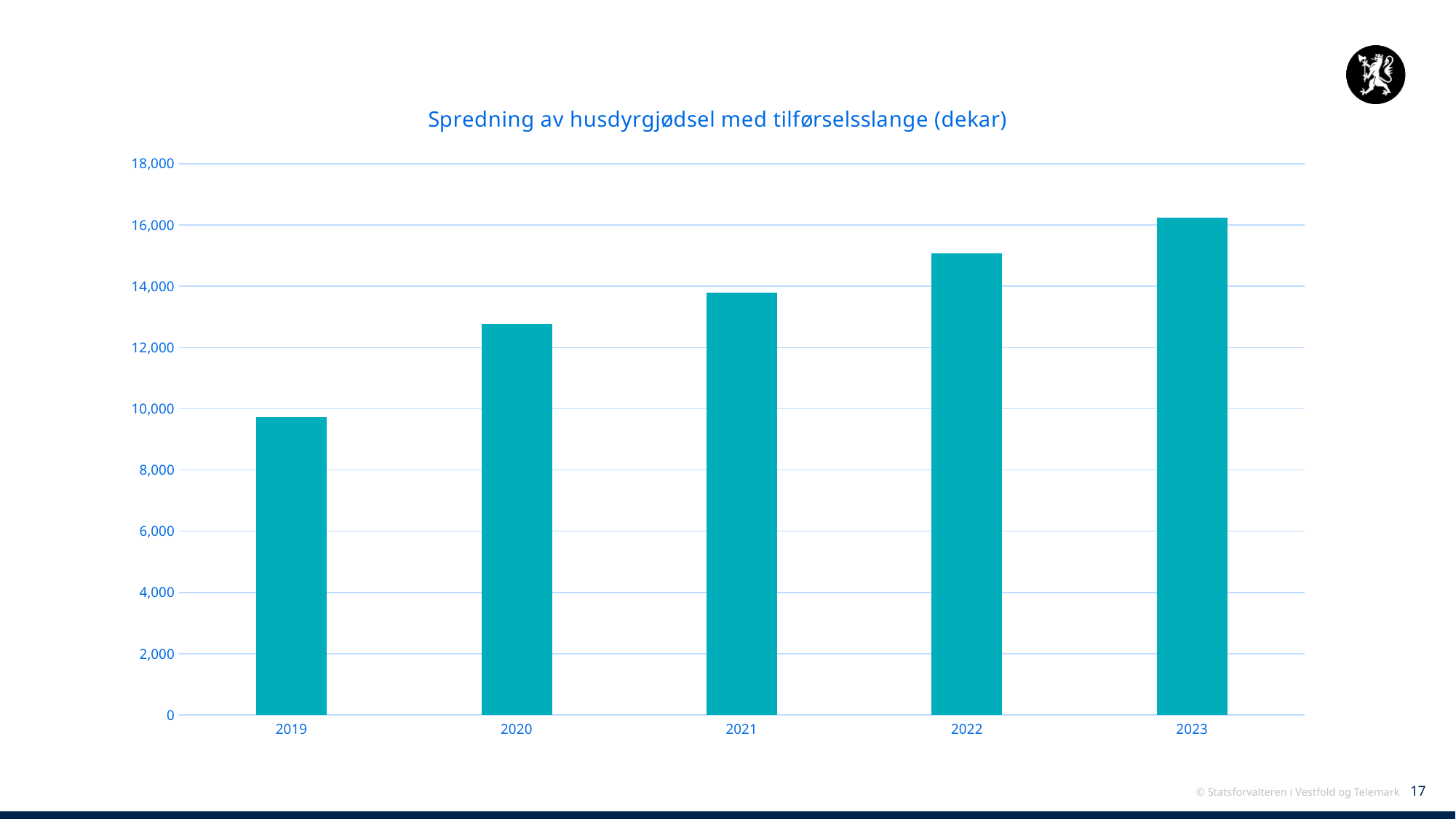
Is the value for 2019 greater or less than 12,000? less Is the value for 2023 greater or less than 14,000? greater What kind of chart is shown on the slide? bar chart What is the title of the chart? Spredning av husdyrgjødsel med tilførselsslange (dekar) Which year has the highest value in the chart? 2023 Which year has the larger value, 2021 or 2019? 2021 How many years are shown on the x axis of the chart? 5 Is the value for 2020 greater or less than 12,000? greater Which year has the lowest value in the chart? 2019 Which year has the larger value, 2020 or 2022? 2022 Do the values rise or fall from 2019 to 2023? rise